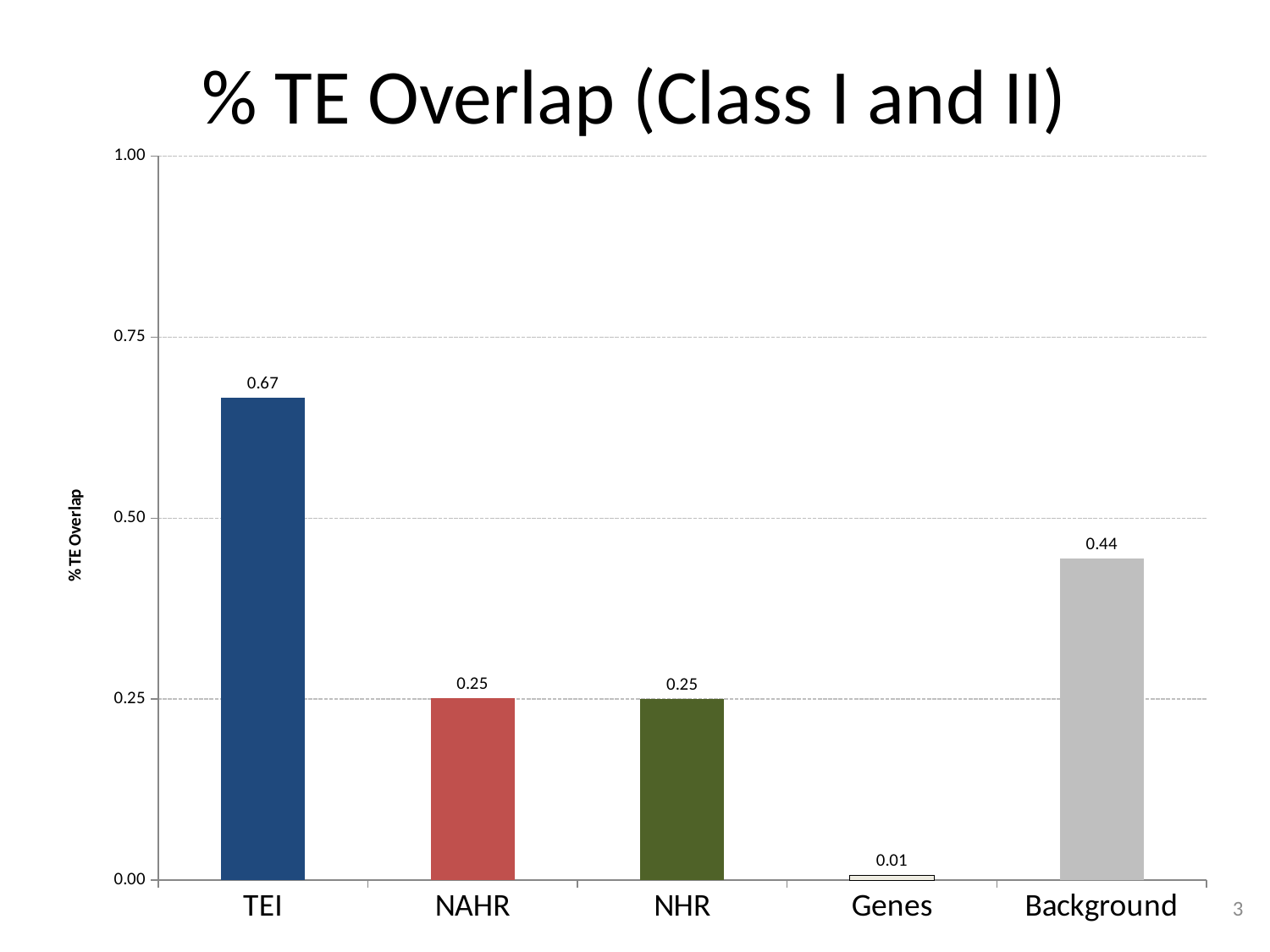
Which category has the highest % TE Overlap? TEI What is the % TE Overlap value for TEI? 0.67 What kind of chart is shown on the slide? bar chart Which has a larger % TE Overlap, Background or NHR? Background How many categories are shown on the x axis? 5 What is the % TE Overlap value for Genes? 0.01 What is the difference between the % TE Overlap values for TEI and Background? 0.23 What is the % TE Overlap value for Background? 0.44 Is the value for TEI greater or less than 0.50? greater Which category has the lowest % TE Overlap? Genes What is the % TE Overlap value for NAHR? 0.25 What is the difference between the % TE Overlap values for NHR and Genes? 0.24